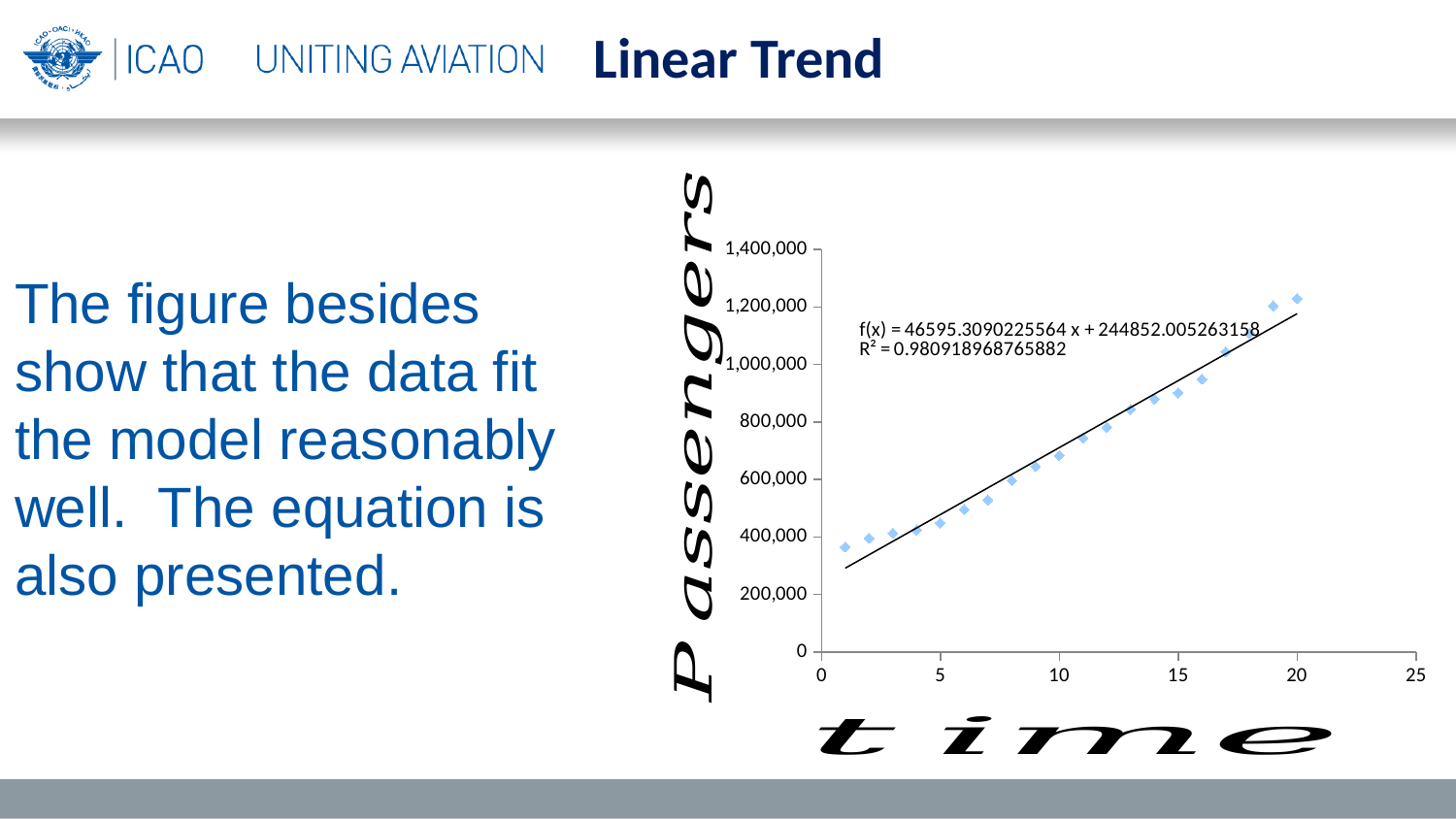
Is the passengers value at time 5 greater or less than 600,000? less Is the passengers value at time 10 greater or less than 600,000? greater Is the passengers value at time 15 greater or less than 800,000? greater What is the label of the horizontal axis of the chart? time Do the plotted passenger values rise or fall as time increases along the x axis? rise At which time value is the plotted passengers value lowest? 1 What is the label of the vertical axis of the chart? Passengers Which has the larger passengers value, time 10 or time 5? time 10 What kind of chart is shown on the slide? scatter chart At which time value is the plotted passengers value highest? 20